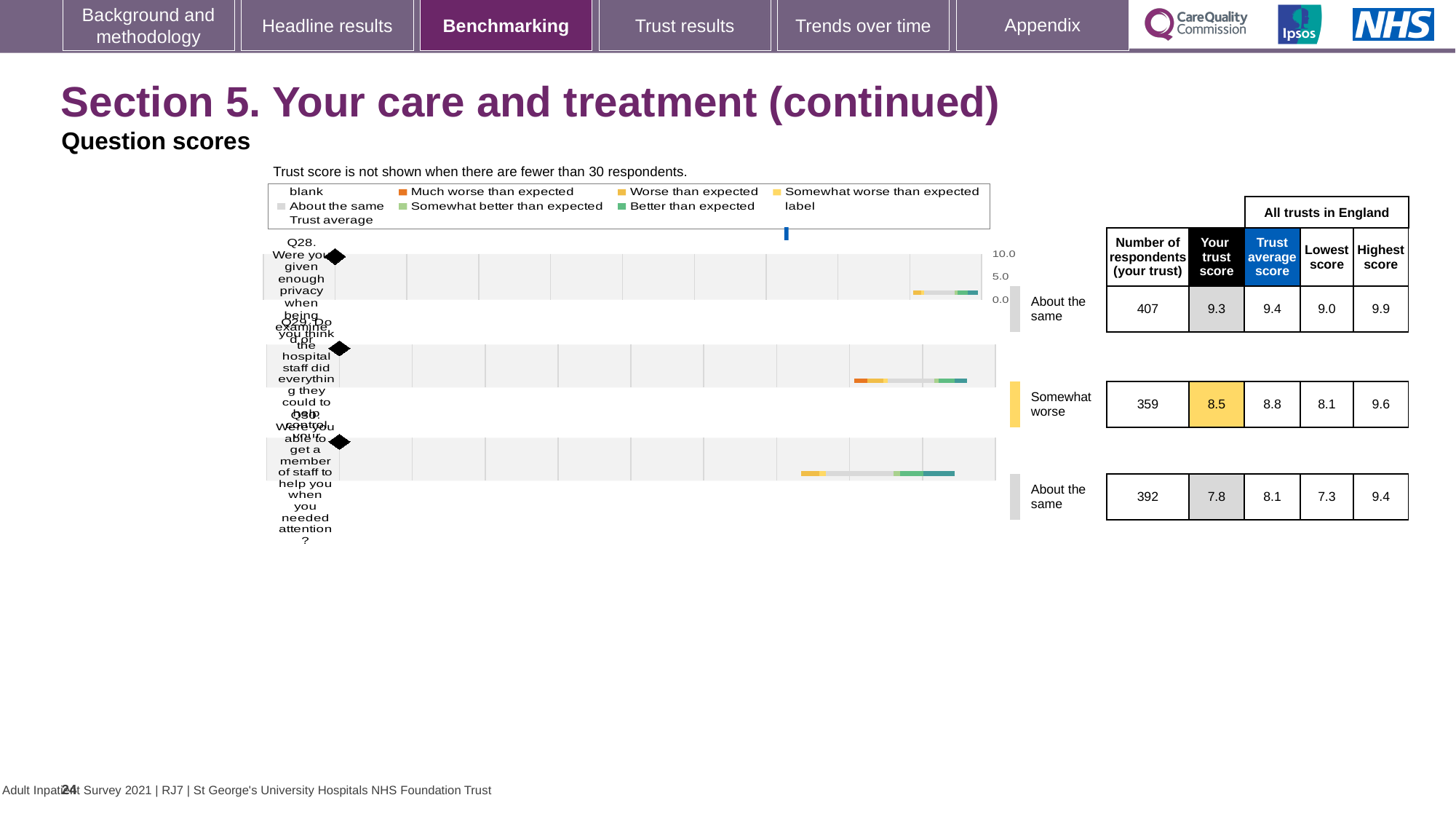
What is the difference between the trust score for Q28 (9.3) and the trust score for Q30 (7.8)? 1.5 What kind of chart is used to show the question scores on this slide? bar chart Which of the three questions has the lowest trust score for this trust? Q30 According to the table beside the chart, what is the trust score for Q28 (Were you given enough privacy when being examined or treated)? 9.3 For Q29, which is larger: this trust's score or the trust average score? Trust average score Is the trust score marker for Q28 on the chart greater or less than 5.0? greater Which benchmark category is shown next to the chart for Q29? Somewhat worse According to the table beside the chart, what is the trust average score for Q30? 8.1 According to the table beside the chart, what is the highest score across all trusts in England for Q28? 9.9 According to the table beside the chart, how many respondents answered Q29 for this trust? 359 Which of the three questions has the highest trust score for this trust? Q28 How many questions (Q28, Q29, Q30) are plotted in the chart area? 3